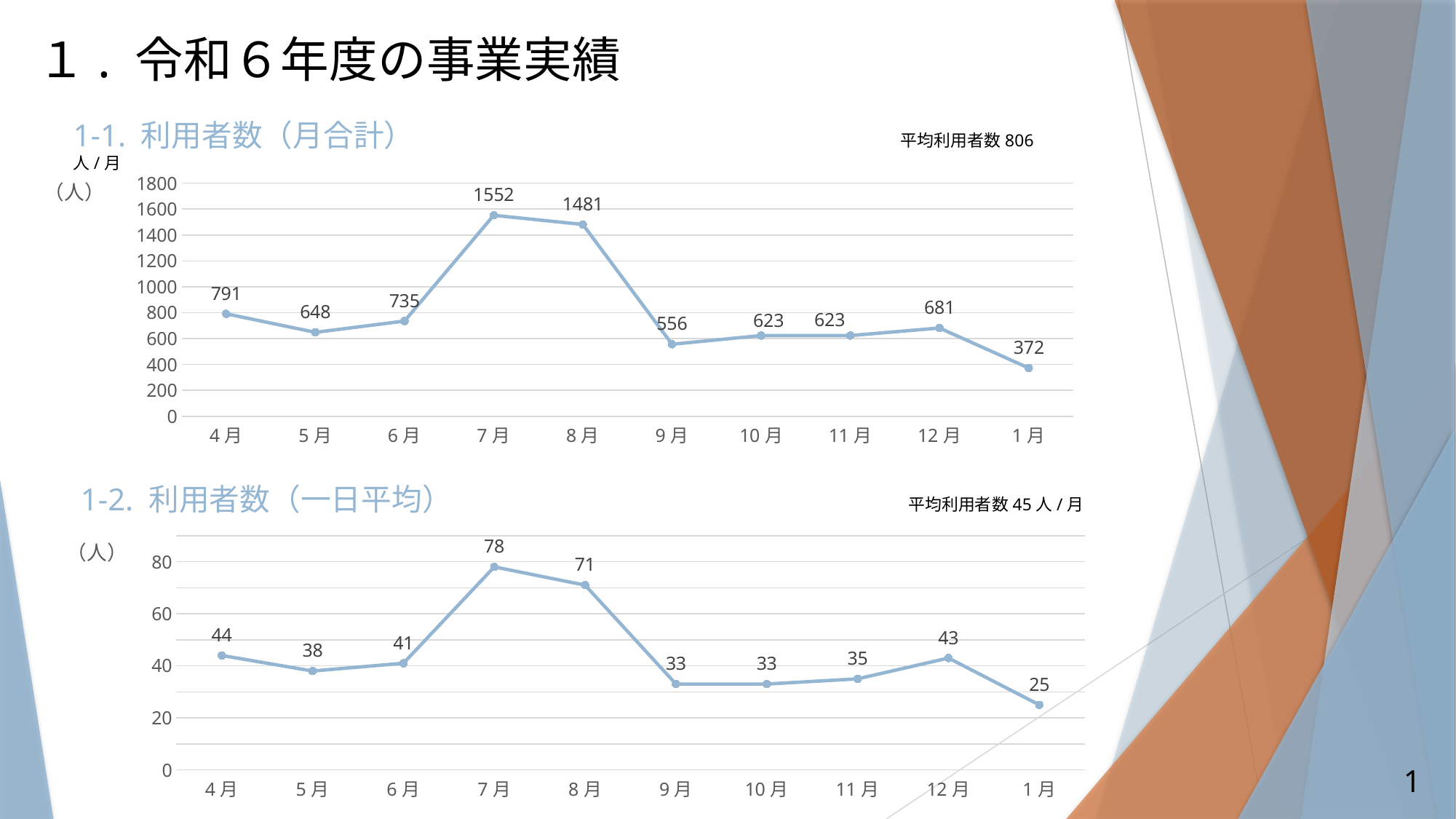
In the top chart (1-1. 利用者数（月合計）), how many months are plotted? 10 In the bottom chart (1-2. 利用者数（一日平均）), which month has the highest value? 7月 What kind of chart is the bottom chart (1-2. 利用者数（一日平均）)? line chart In the top chart (1-1. 利用者数（月合計）), which month has the lowest value? 1月 In the top chart (1-1. 利用者数（月合計）), what is the value for 7月? 1552 In the bottom chart (1-2. 利用者数（一日平均）), do the values rise or fall from 8月 to 9月? fall In the bottom chart (1-2. 利用者数（一日平均）), which is larger, the value for 5月 or the value for 6月? 6月 In the top chart (1-1. 利用者数（月合計）), what is the difference between the values for 7月 and 8月? 71 In the top chart (1-1. 利用者数（月合計）), is the value for 4月 greater or less than 1000? less In the top chart (1-1. 利用者数（月合計）), what is the value for 1月? 372 In the bottom chart (1-2. 利用者数（一日平均）), what is the difference between the values for 4月 and 1月? 19 In the bottom chart (1-2. 利用者数（一日平均）), what is the value for 12月? 43